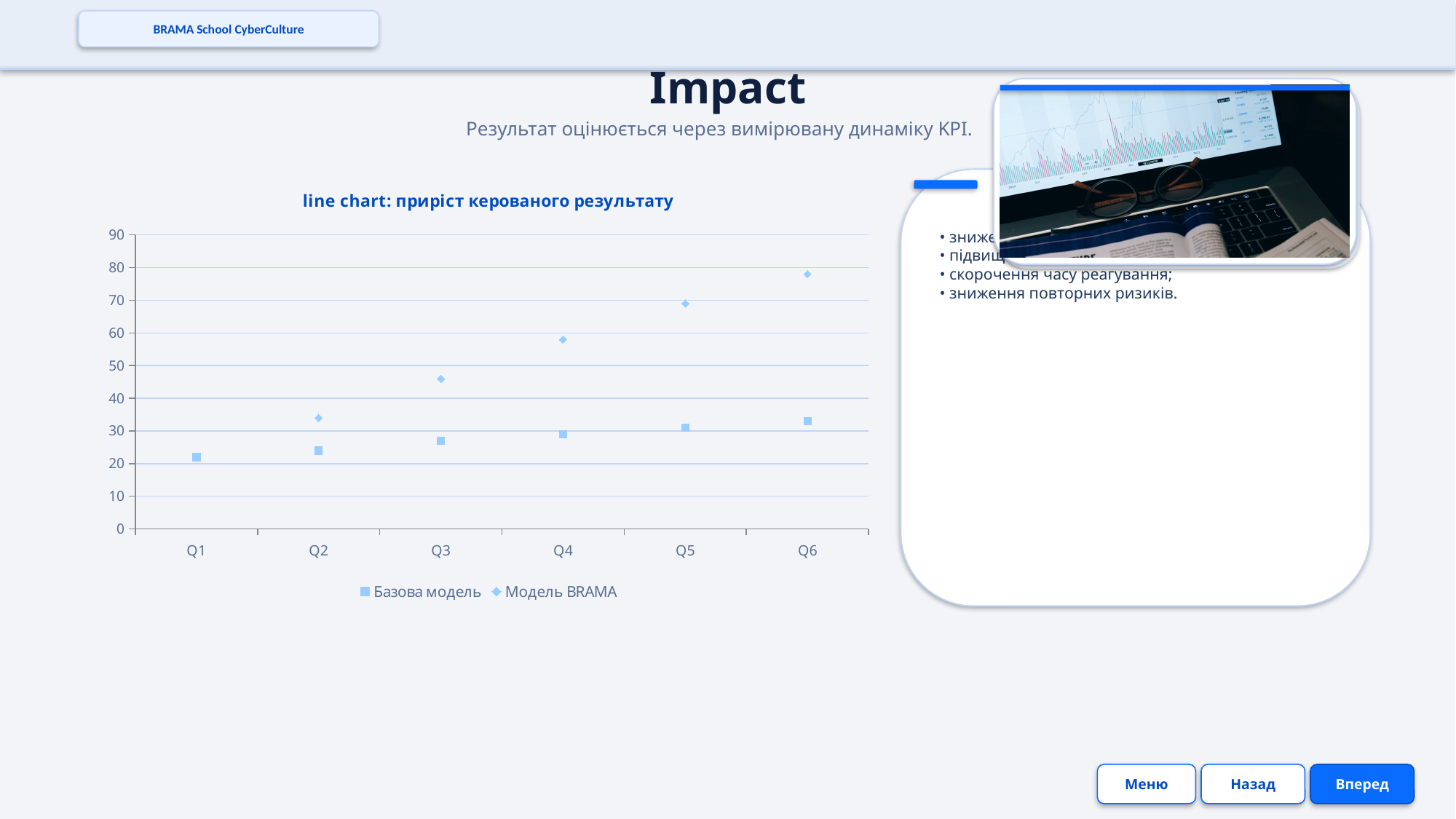
Is the value for Модель BRAMA at Q6 greater or less than 70? greater What is the title of the chart? line chart: приріст керованого результату How many series does the legend list? 2 Is the value for Базова модель at Q3 greater or less than 30? less Is the value for Модель BRAMA at Q3 greater or less than 50? less At Q4, which series has the larger value, Базова модель or Модель BRAMA? Модель BRAMA Do the values for Модель BRAMA rise or fall from Q2 to Q6? rise Which series is shown with diamond markers in the legend? Модель BRAMA At which quarter is Базова модель at its lowest value? Q1 How many quarters are shown on the x axis? 6 At which quarter does Модель BRAMA reach its highest value? Q6